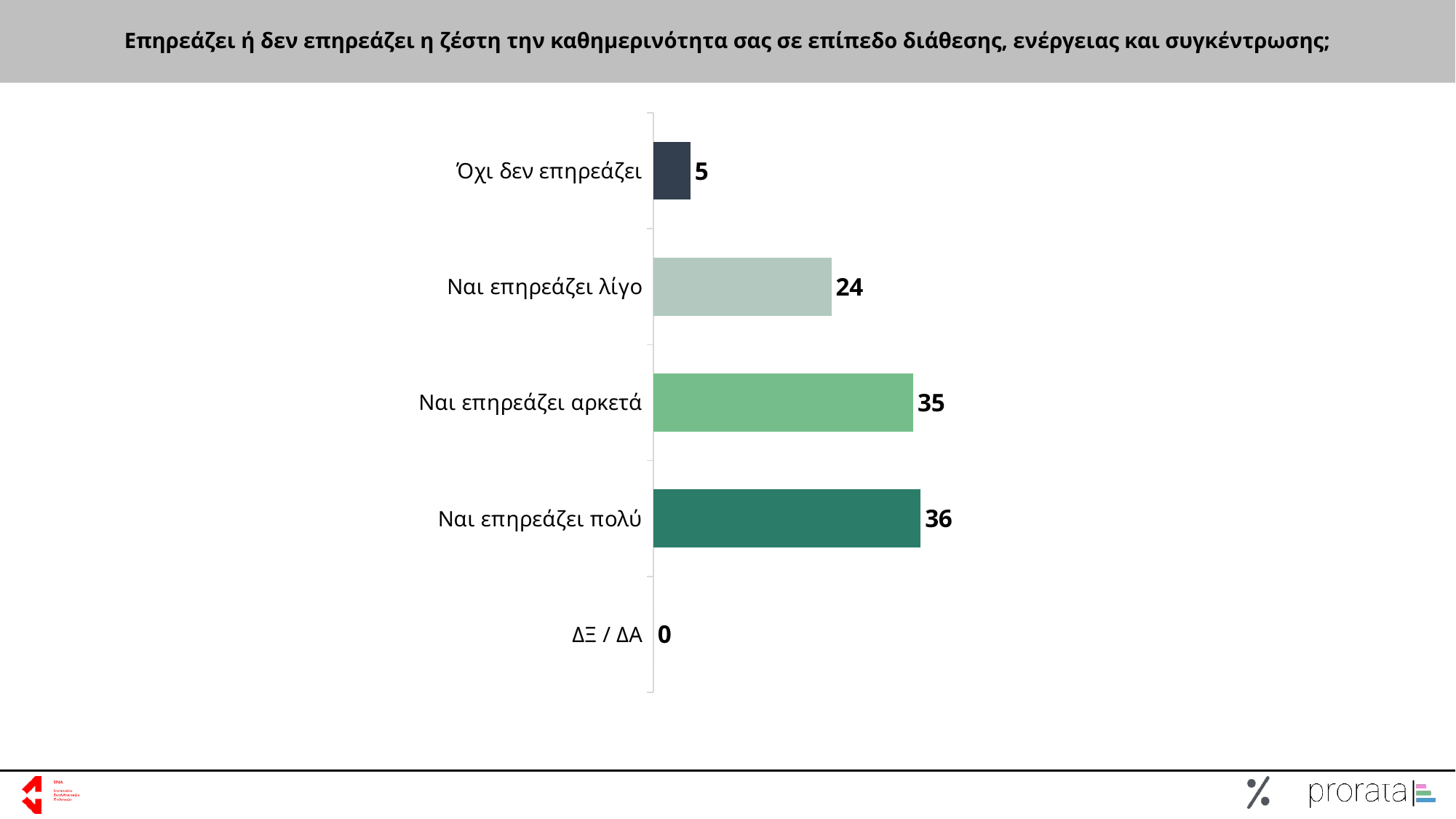
What is the value for "ΔΞ / ΔΑ"? 0 What is the combined value of "Ναι επηρεάζει αρκετά" and "Ναι επηρεάζει πολύ"? 71 What is the difference between the values for "Ναι επηρεάζει αρκετά" and "Ναι επηρεάζει λίγο"? 11 What is the value for "Ναι επηρεάζει πολύ"? 36 Which category has the lowest value? ΔΞ / ΔΑ What colour is the bar for "Όχι δεν επηρεάζει"? Dark navy blue Which is larger, the value for "Ναι επηρεάζει λίγο" or the value for "Όχι δεν επηρεάζει"? Ναι επηρεάζει λίγο What is the value for "Ναι επηρεάζει λίγο"? 24 How many categories are shown in the chart? 5 What is the value for "Όχι δεν επηρεάζει"? 5 What kind of chart is shown on the slide? Bar chart Which category has the highest value? Ναι επηρεάζει πολύ